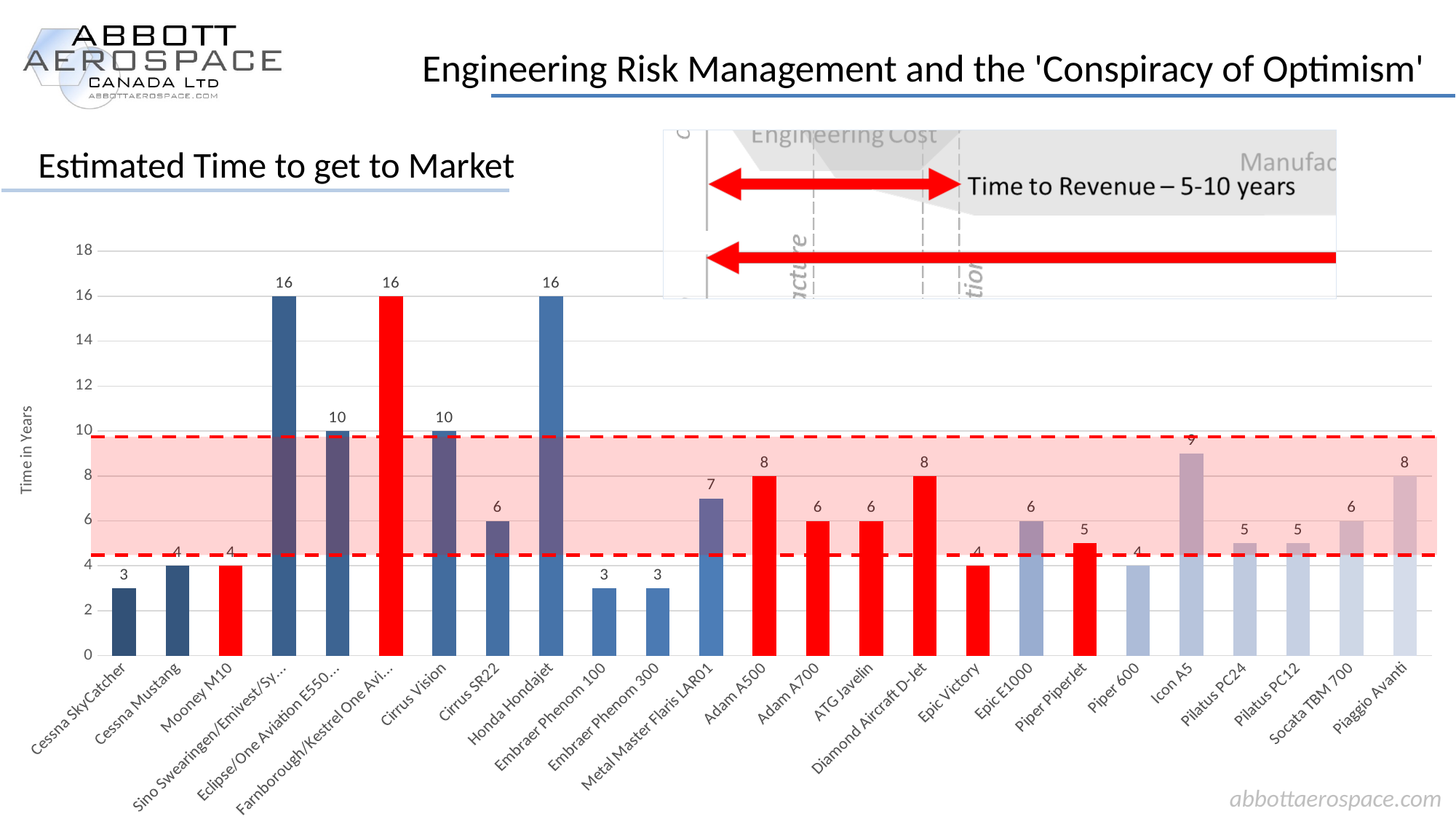
What kind of chart is shown on the slide? bar chart What is the lowest value plotted on the chart? 3 What is the difference between the values for Cirrus Vision and Cirrus SR22? 4 What is the value shown for Piaggio Avanti? 8 Which has a larger value, Icon A5 or Pilatus PC24? Icon A5 Is the value for Honda Hondajet greater or less than 10? greater What is the value shown for Metal Master Flaris LAR01? 7 What is the value shown for Icon A5? 9 What is the label on the vertical axis of the chart? Time in Years How many aircraft categories are plotted on the chart? 25 What is the highest value plotted on the chart? 16 What is the estimated time to get to market for Honda Hondajet? 16